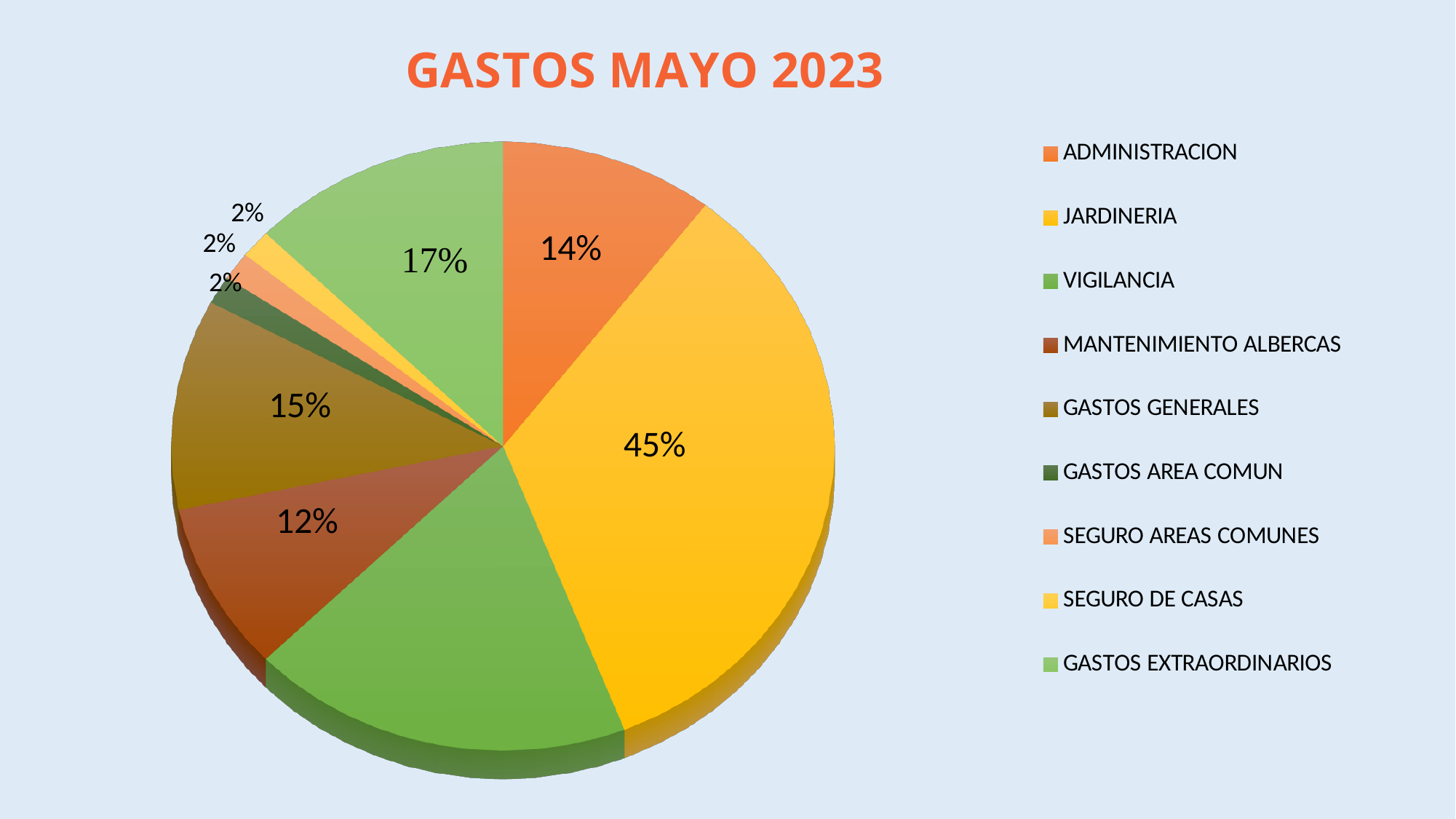
What kind of chart is shown on the slide? Pie chart What is the value shown for MANTENIMIENTO ALBERCAS? 12% What is the title of the chart? GASTOS MAYO 2023 What is the value shown for GASTOS EXTRAORDINARIOS? 17% How many categories does the legend list? 9 What percentage of the pie does JARDINERIA represent? 45% What is the difference in percentage points between JARDINERIA and ADMINISTRACION? 31 What is the value shown for ADMINISTRACION? 14% Which category has the largest slice of the pie? JARDINERIA What is the value shown for GASTOS GENERALES? 15% What colour is the slice for JARDINERIA? Yellow Which is larger, the slice for ADMINISTRACION or the slice for GASTOS GENERALES? GASTOS GENERALES